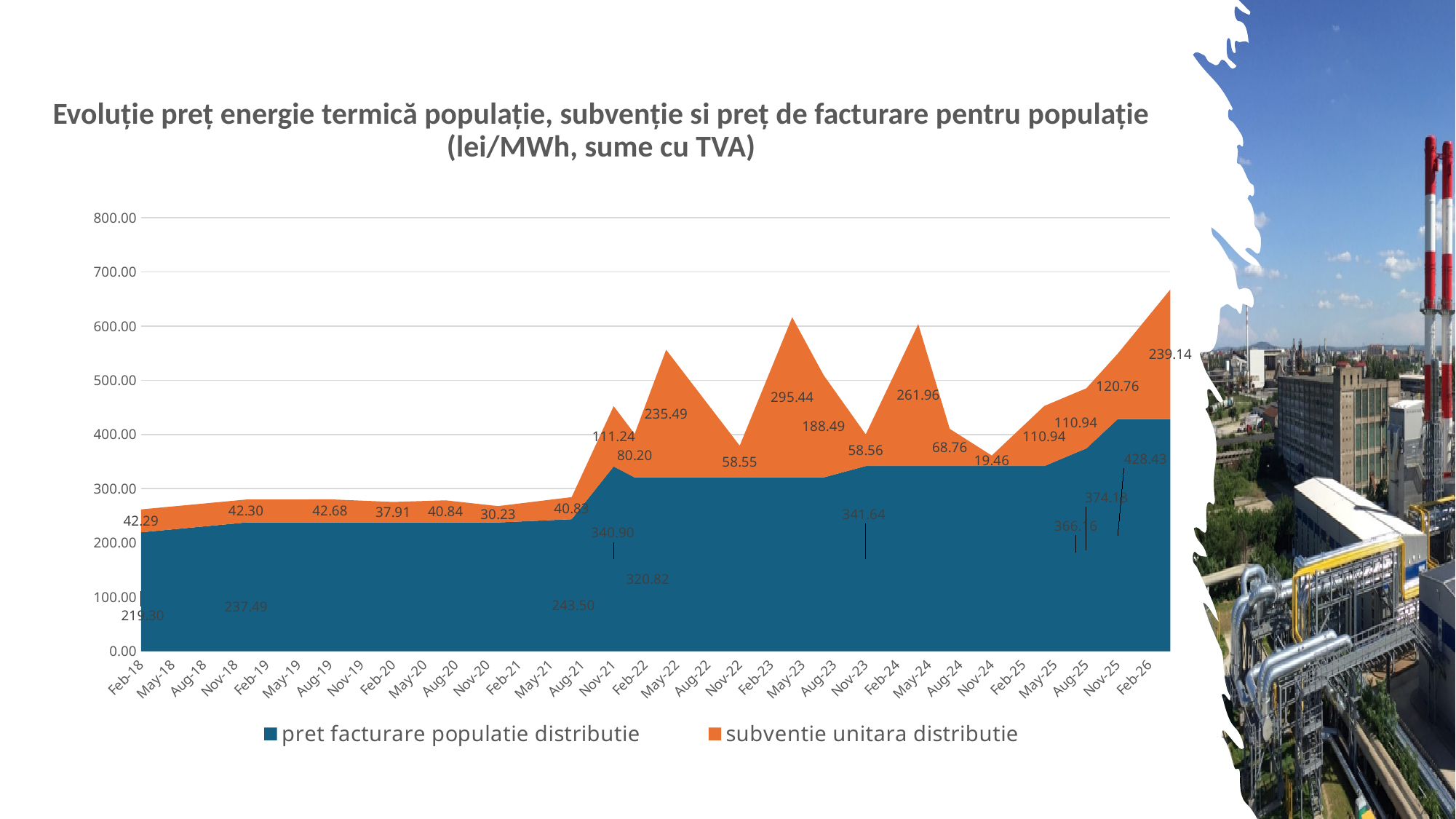
What is the lowest labelled value of 'subventie unitara distributie'? 19.46 How many series does the legend list? 2 What is the value of 'subventie unitara distributie' at Feb-18? 42.29 What kind of chart is shown on the slide? Stacked area chart What are the two series named in the legend? pret facturare populatie distributie; subventie unitara distributie What is the highest labelled value of 'subventie unitara distributie'? 295.44 What is the value of 'pret facturare populatie distributie' at Feb-26? 428.43 What is the difference between the 'pret facturare populatie distributie' values at Feb-26 and Feb-18? 209.13 What is the value of 'pret facturare populatie distributie' at Feb-18? 219.30 How many time points are shown on the x axis? 33